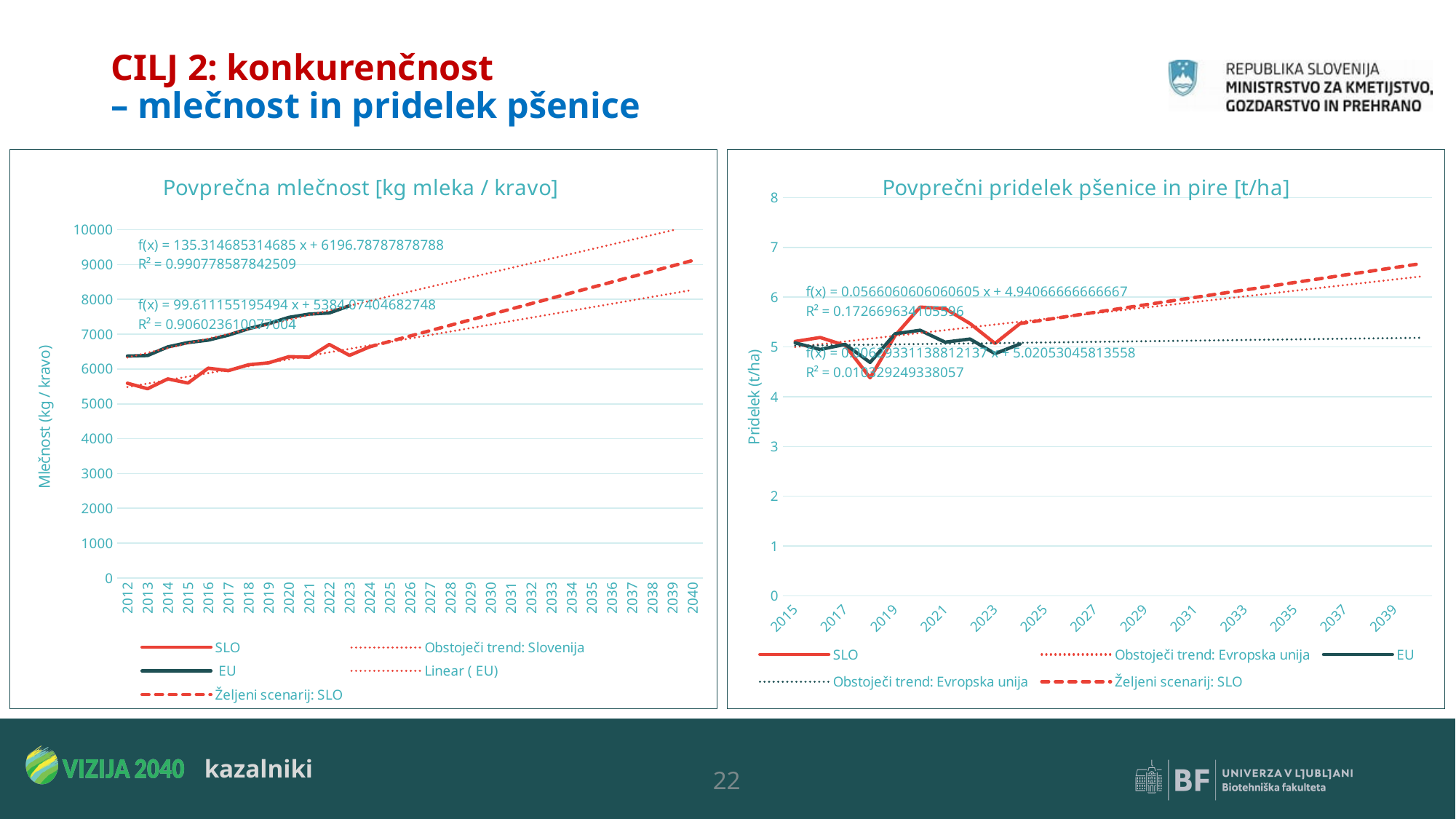
In the left chart 'Povprečna mlečnost', does the SLO series generally rise or fall from 2012 to 2023? rise In the right chart 'Povprečni pridelek pšenice in pire', is the SLO value for 2019 greater or less than 5? greater In the left chart 'Povprečna mlečnost', which series is higher in 2023, SLO or EU? EU In the left chart 'Povprečna mlečnost', is the EU value for 2023 greater or less than 7000? greater In the left chart 'Povprečna mlečnost', is the SLO value for 2012 greater or less than 6000? less What kind of chart is the left chart, 'Povprečna mlečnost [kg mleka / kravo]'? line chart How many entries does the legend of the left chart 'Povprečna mlečnost' list? 5 How many entries does the legend of the right chart 'Povprečni pridelek pšenice in pire' list? 5 What is the y-axis label of the left chart 'Povprečna mlečnost'? Mlečnost (kg / kravo) What is the title of the right chart? Povprečni pridelek pšenice in pire [t/ha]